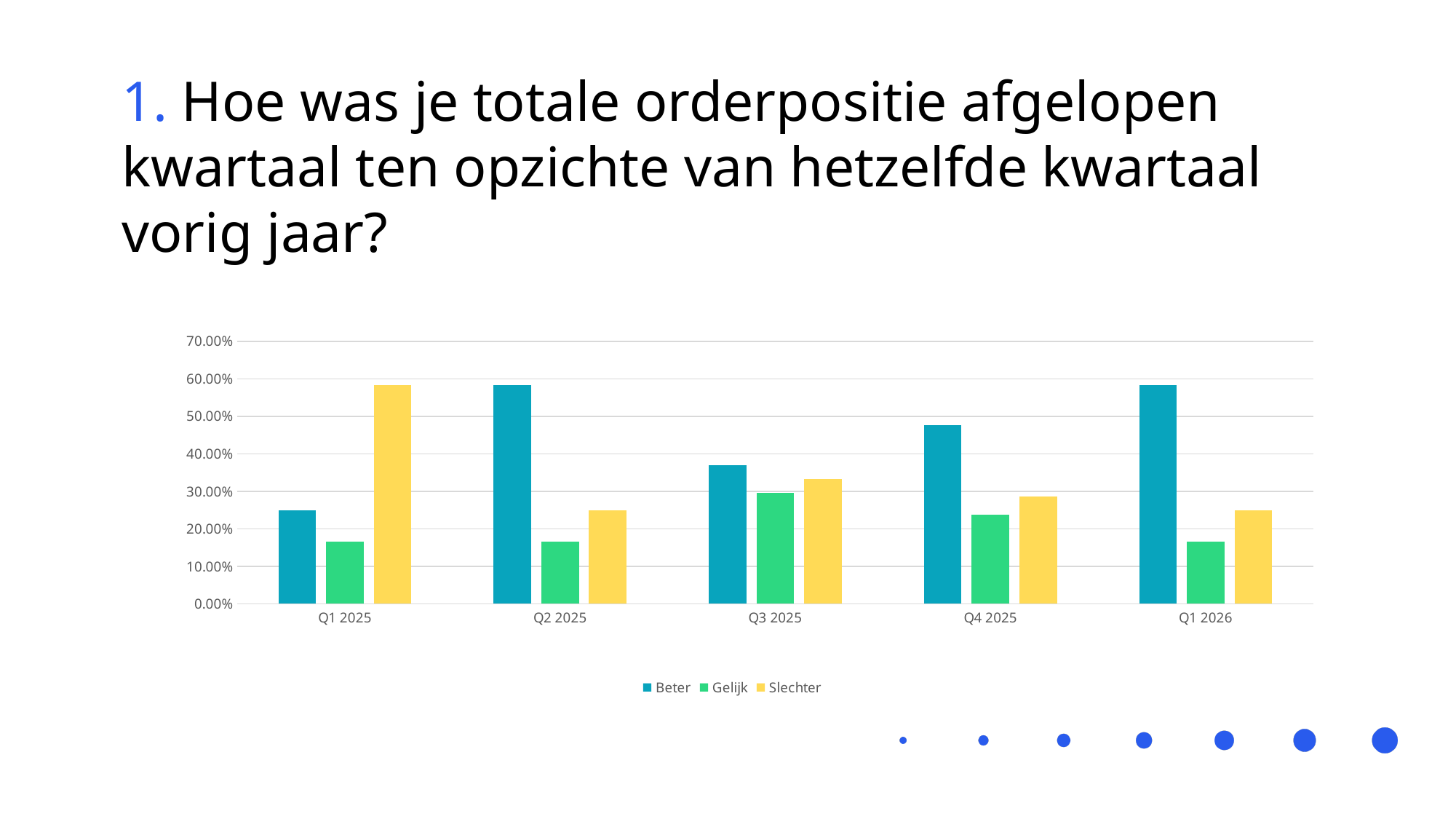
Does the Beter value rise or fall from Q3 2025 to Q1 2026? rise In which quarter is the Slechter value the highest? Q1 2025 How many series does the chart's legend list? 3 Is the value for Slechter in Q1 2025 greater or less than 50%? greater What are the three series named in the chart's legend? Beter, Gelijk, Slechter Is the value for Beter in Q3 2025 greater or less than 40%? less In Q4 2025, which is larger: Beter or Slechter? Beter Which series has the lowest value in Q1 2025? Gelijk How many quarters are shown on the x axis of the chart? 5 Is the value for Gelijk in Q1 2026 greater or less than 20%? less What kind of chart is shown on the slide? bar chart